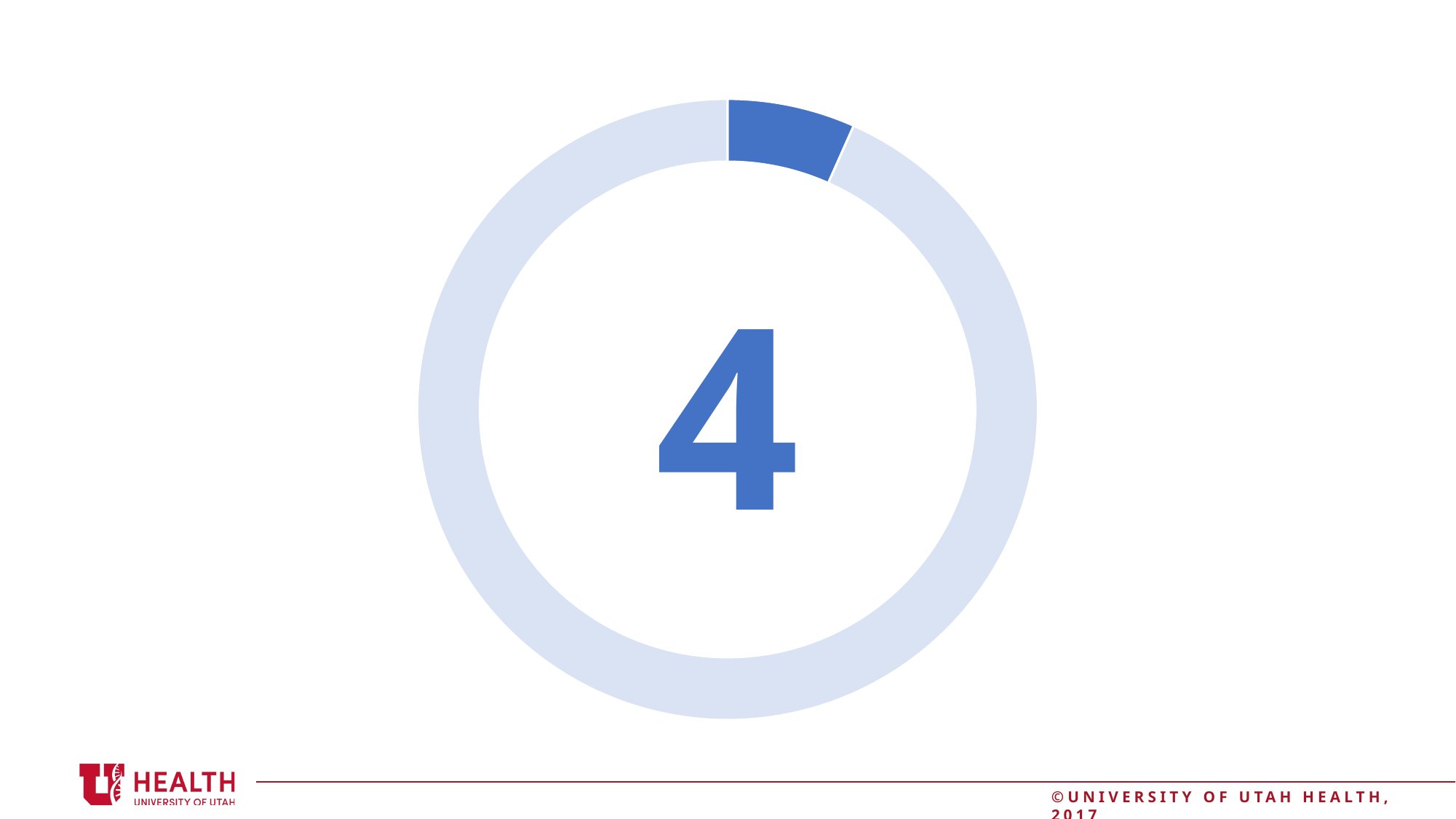
What colour is the small segment at the top of the doughnut chart? Dark blue Which segment of the doughnut chart is the smallest? The dark blue segment What number is displayed in the centre of the doughnut chart? 4 Which segment of the doughnut chart is larger, the dark blue one or the light blue one? The light blue one How many segments does the doughnut chart have? 2 What kind of chart is shown on the slide? Doughnut chart